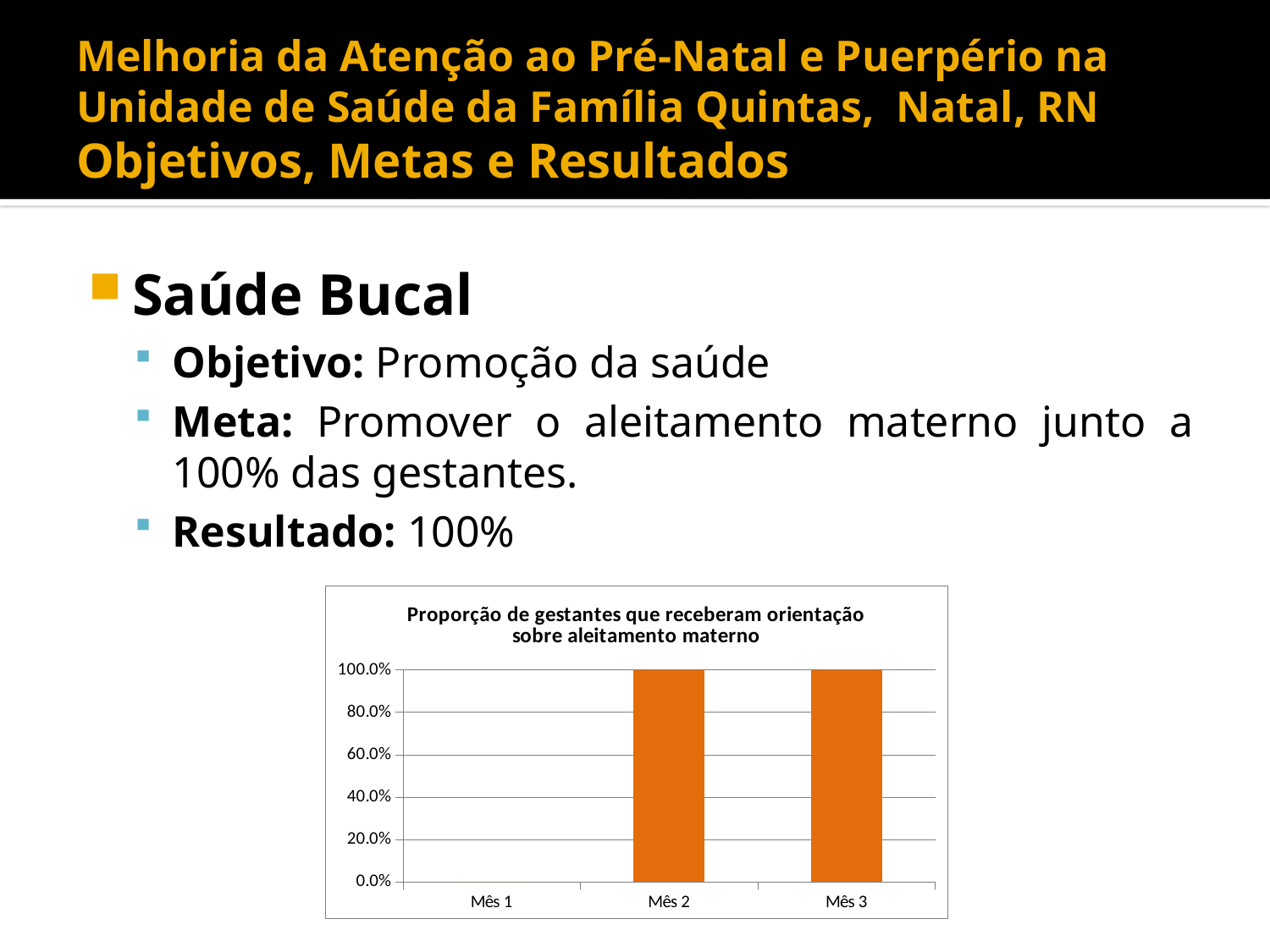
Which is larger, the value for Mês 1 or the value for Mês 2? Mês 2 What is the value for Mês 1 in the chart? 0.0% Is the value for Mês 3 greater or less than 80.0%? greater What is the title of the chart? Proporção de gestantes que receberam orientação sobre aleitamento materno What is the difference between the values for Mês 2 and Mês 1? 100.0% How many categories are shown on the x axis of the chart? 3 Which month has the lowest value in the chart? Mês 1 What is the value for Mês 2 in the chart? 100.0% Do the values rise or fall from Mês 1 to Mês 2? Rise What colour are the bars in the chart? Orange What kind of chart is shown on the slide? Bar chart What is the value for Mês 3 in the chart? 100.0%